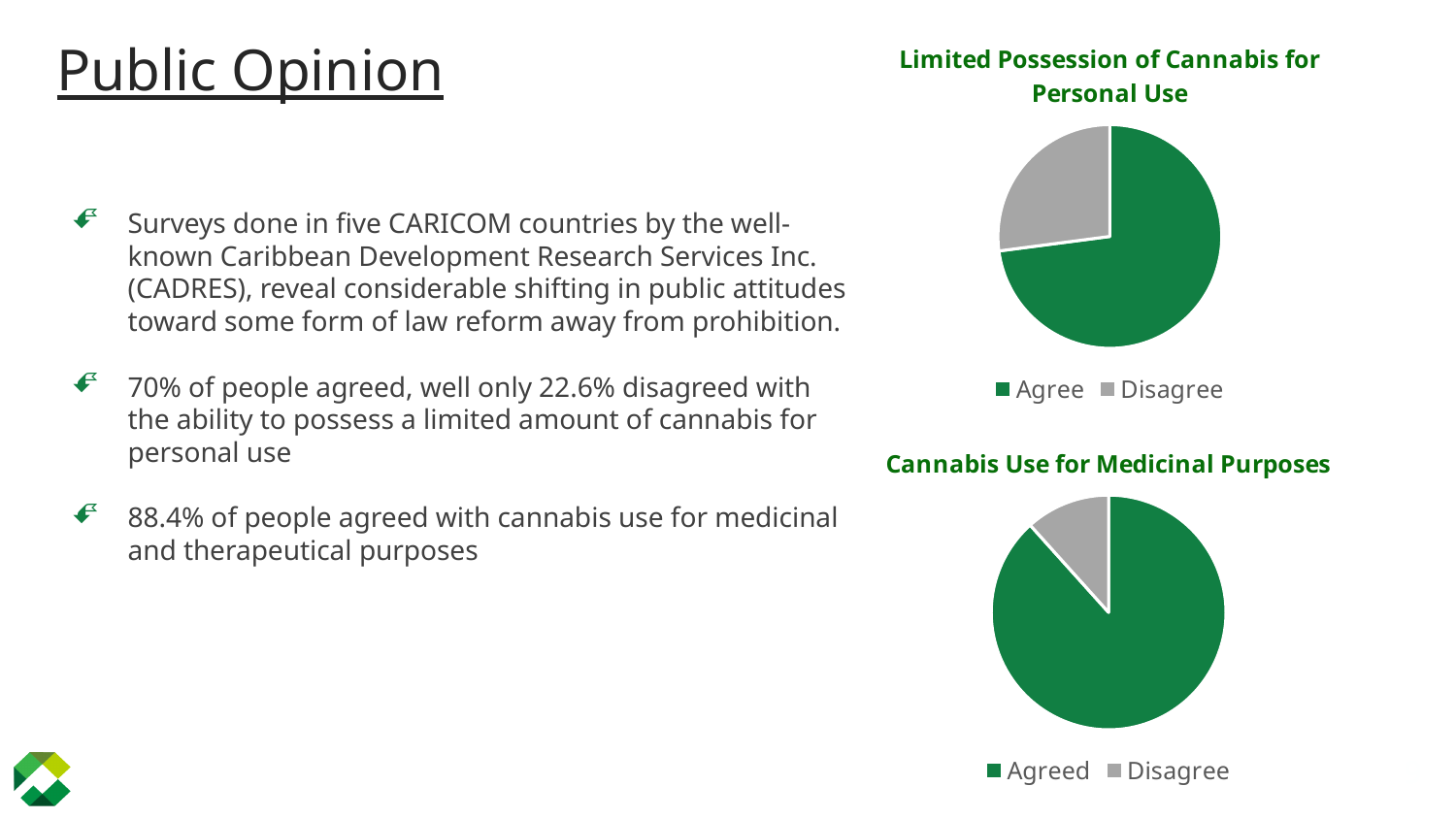
In the "Cannabis Use for Medicinal Purposes" chart, which slice is the smallest? Disagree In the "Limited Possession of Cannabis for Personal Use" chart, which slice is the largest? Agree What kind of chart is the "Cannabis Use for Medicinal Purposes" chart? pie chart In the "Cannabis Use for Medicinal Purposes" chart, which slice is the largest? Agreed What kind of chart is the "Limited Possession of Cannabis for Personal Use" chart? pie chart How many entries does the legend of the "Cannabis Use for Medicinal Purposes" chart list? 2 What is the title of the top chart on the slide? Limited Possession of Cannabis for Personal Use In the "Limited Possession of Cannabis for Personal Use" chart, is the Agree slice larger or smaller than the Disagree slice? larger In the "Cannabis Use for Medicinal Purposes" chart, is the Disagree slice larger or smaller than the Agreed slice? smaller How many slices does the "Limited Possession of Cannabis for Personal Use" pie chart have? 2 In the "Cannabis Use for Medicinal Purposes" chart, what colour is the Agreed slice? green In the "Limited Possession of Cannabis for Personal Use" chart, which slice is the smallest? Disagree